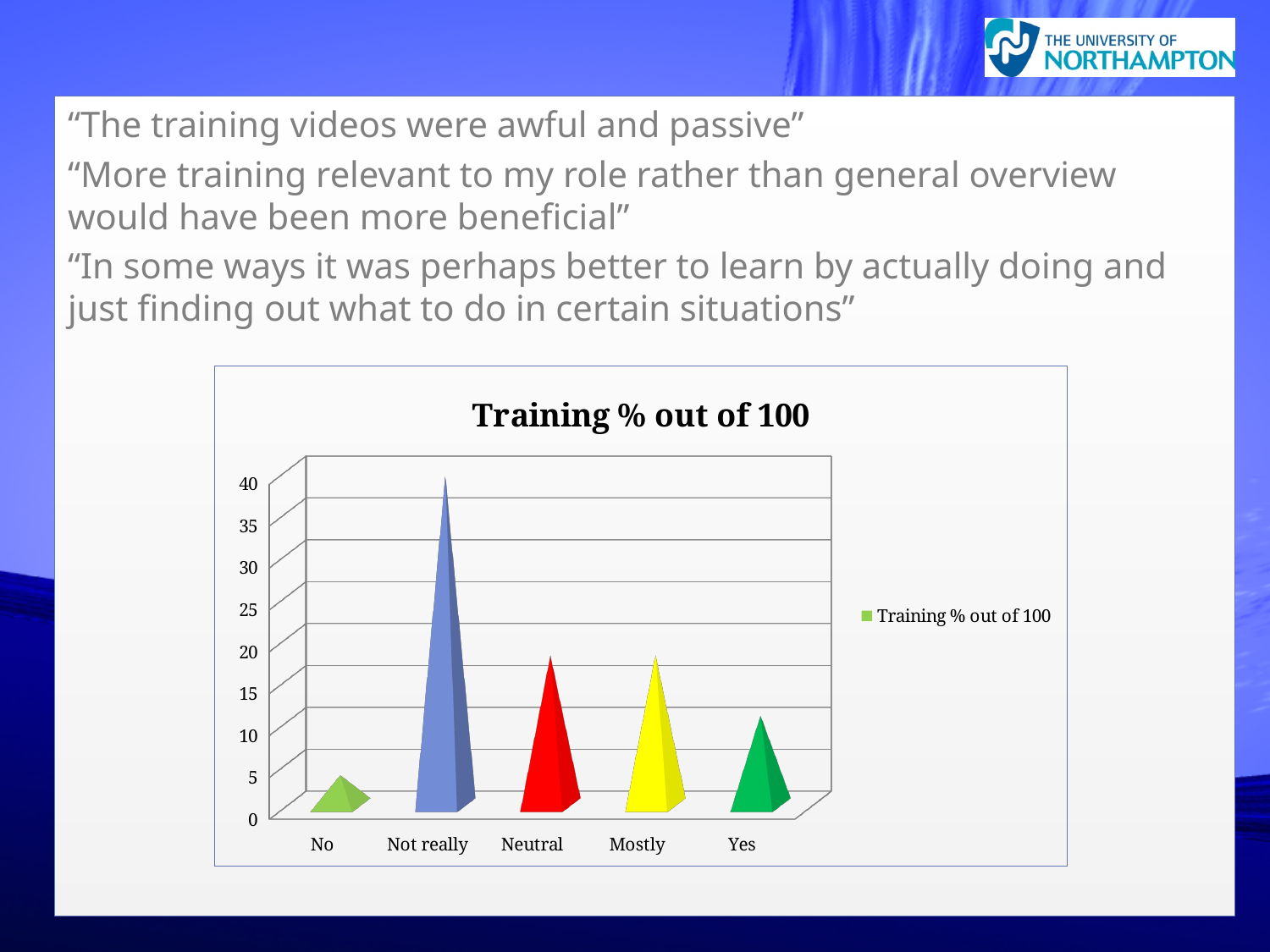
Is the value for No greater or less than 10? less What kind of chart is shown on the slide? bar chart How many series does the chart's legend list? 1 Which is larger, the value for Not really or the value for Yes? Not really What is the title of the chart? Training % out of 100 How many categories are shown on the x axis of the chart? 5 Is the value for Not really greater or less than 30? greater Which category has the lowest value in the chart? No Is the value for Neutral greater or less than 10? greater Which category has the highest value in the chart? Not really Which is larger, the value for Neutral or the value for No? Neutral